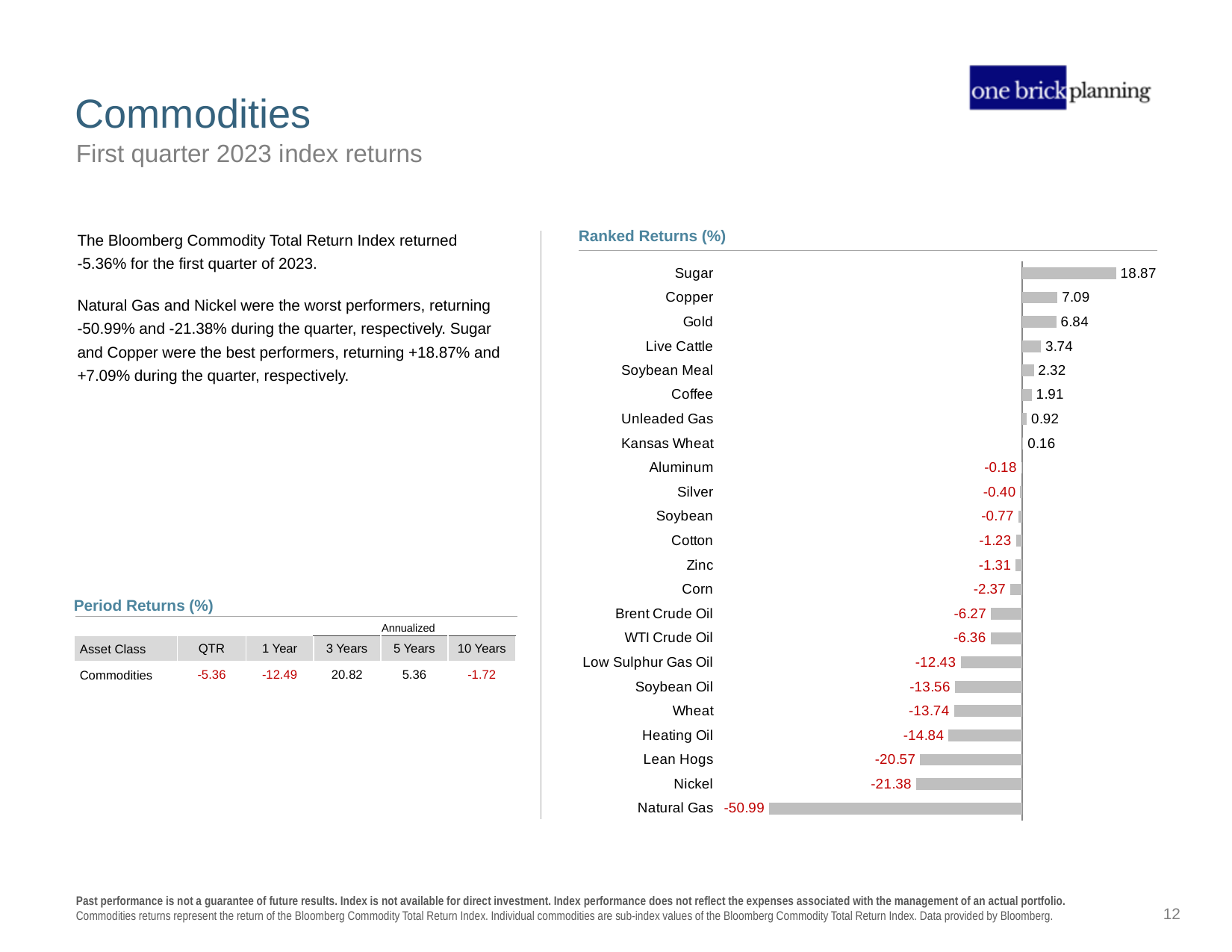
Which commodity has the lowest value in the Ranked Returns (%) chart? Natural Gas What is the value for Low Sulphur Gas Oil in the Ranked Returns (%) chart? -12.43 Which has the larger value in the Ranked Returns (%) chart, Coffee or Soybean Meal? Soybean Meal How many commodities are shown in the Ranked Returns (%) chart? 23 What type of chart is the Ranked Returns (%) chart? Bar chart What is the value for Sugar in the Ranked Returns (%) chart? 18.87 What is the difference between the values for Copper and Gold in the Ranked Returns (%) chart? 0.25 What is the value for Natural Gas in the Ranked Returns (%) chart? -50.99 What is the difference between the values for Nickel and Lean Hogs in the Ranked Returns (%) chart? 0.81 What is the title of the chart on the right side of the slide? Ranked Returns (%) What is the value for Live Cattle in the Ranked Returns (%) chart? 3.74 Which commodity has the highest value in the Ranked Returns (%) chart? Sugar